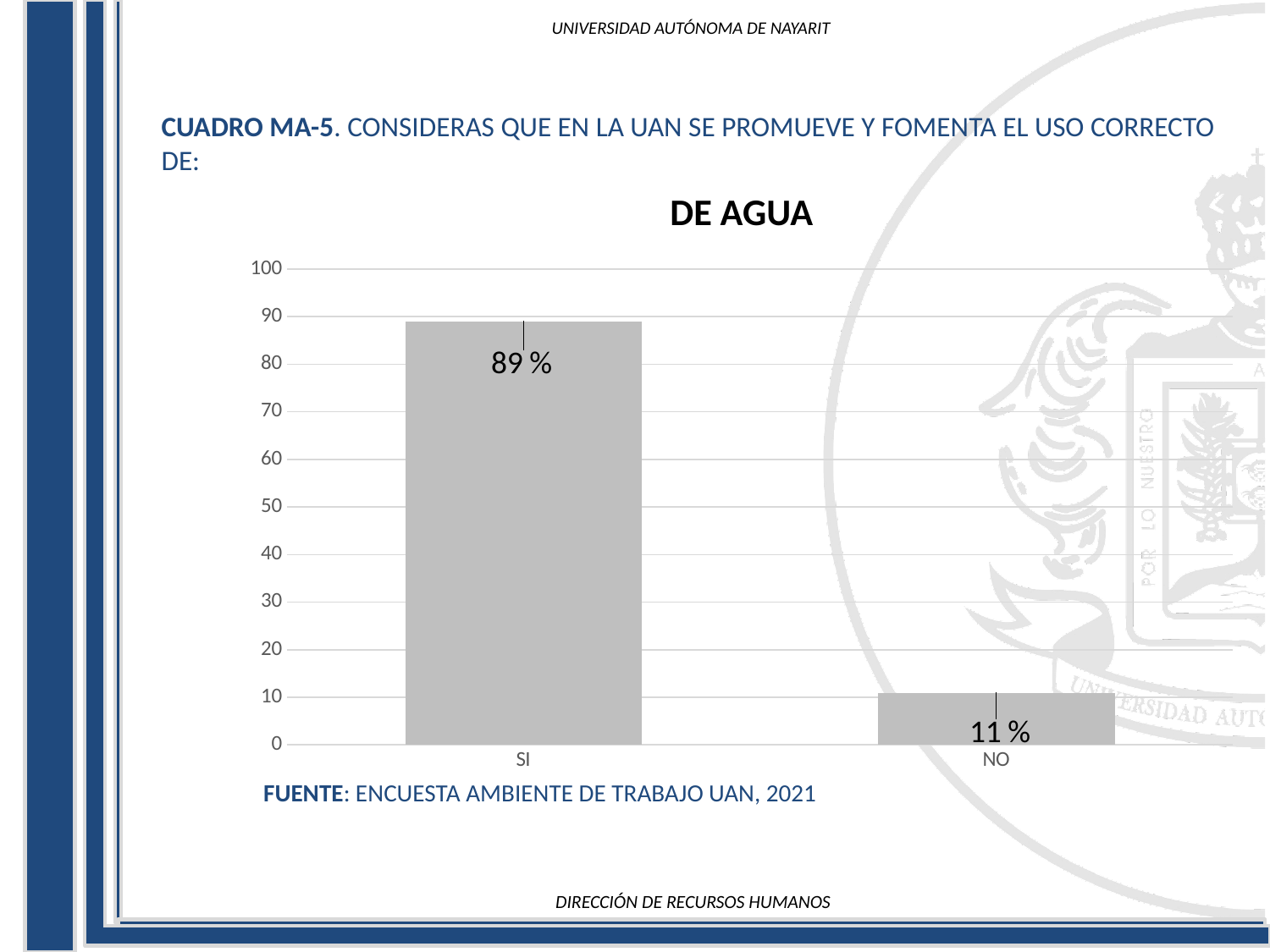
What is the title of the chart? DE AGUA Is the value for SI greater or less than 80? greater Which is larger, the value for SI or the value for NO? SI What is the value for NO? 11 % What is the maximum value shown on the vertical axis? 100 How many categories are shown on the x axis? 2 Which category has the lowest value? NO What kind of chart is shown? bar chart Is the value for NO greater or less than 20? less What is the value for SI? 89 % What is the difference between the values for SI and NO? 78 % Which category has the highest value? SI